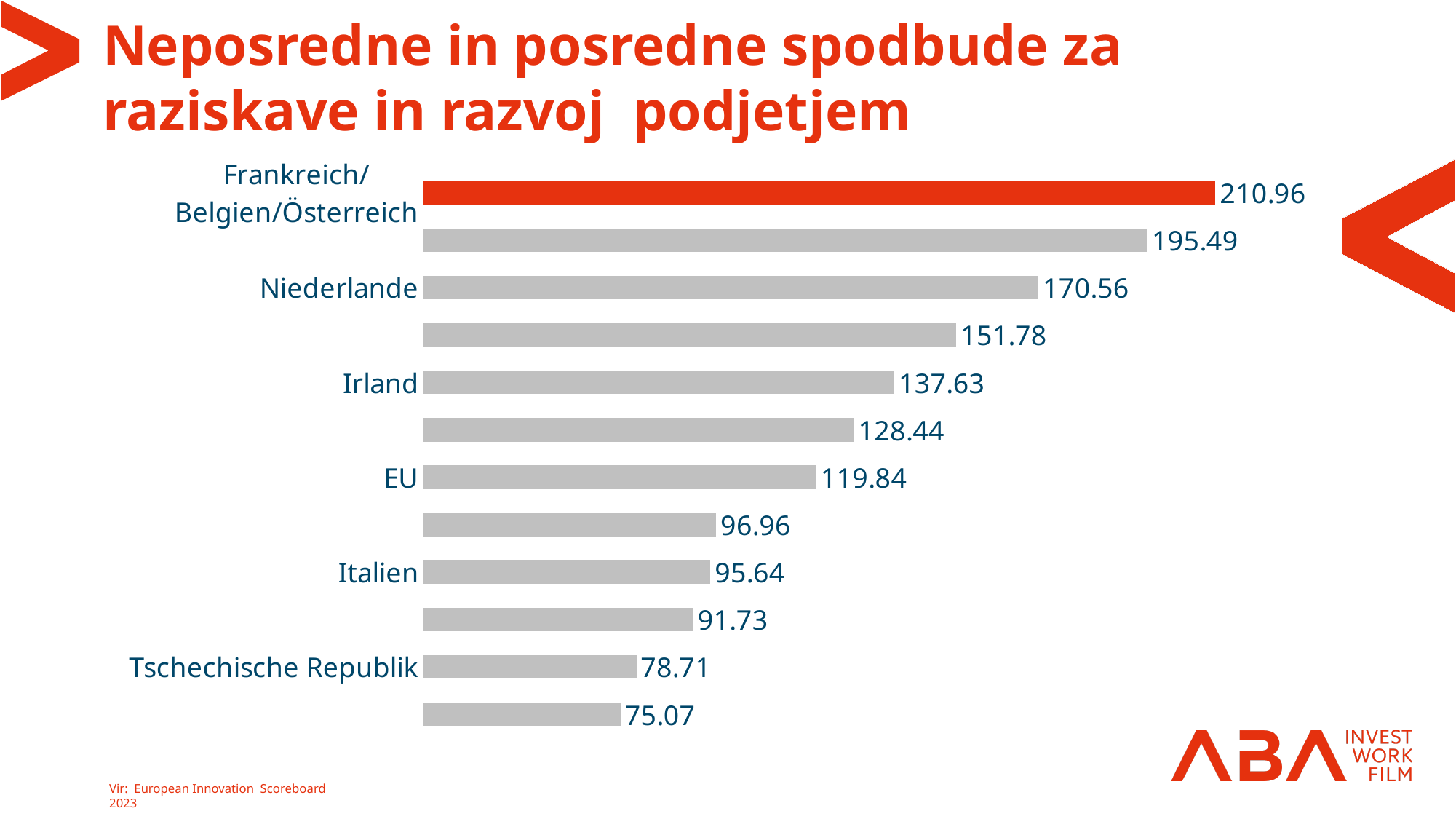
Which category has the highest value? Frankreich/Belgien/Österreich What is the value for Frankreich/Belgien/Österreich? 210.96 What is the lowest value shown in the chart? 75.07 How many bars are shown in the chart? 12 What type of chart is shown on the slide? bar chart What is the value for Irland? 137.63 What is the value for Tschechische Republik? 78.71 What is the difference between the values for Niederlande and Irland? 32.93 Which is larger, the value for Irland or the value for EU? Irland What is the value for EU? 119.84 What is the value for Italien? 95.64 What is the value for Niederlande? 170.56